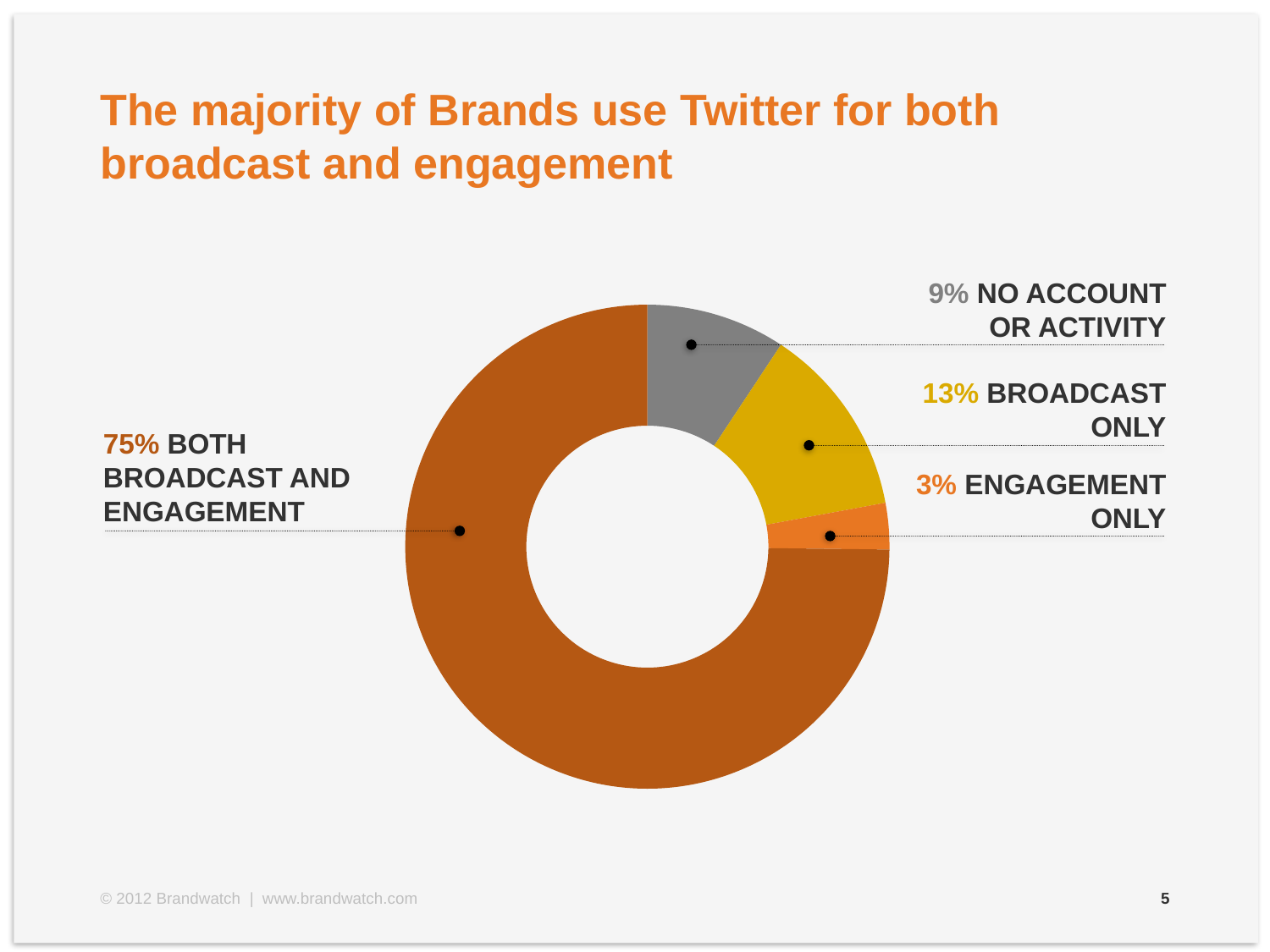
How many categories are shown in the chart? 4 What percentage of brands use Twitter for engagement only? 3% What percentage of brands have no Twitter account or activity? 9% What is the difference in percentage points between broadcast only and engagement only? 10 What percentage of brands use Twitter for broadcast only? 13% What kind of chart is shown on the slide? Doughnut (pie) chart Which is larger: the share for broadcast only or the share for no account or activity? Broadcast only What colour is the segment for no account or activity? Grey Which category has the largest share of the chart? Both broadcast and engagement What percentage of brands use Twitter for both broadcast and engagement? 75% Which category has the smallest share of the chart? Engagement only What is the combined share of broadcast only and engagement only? 16%